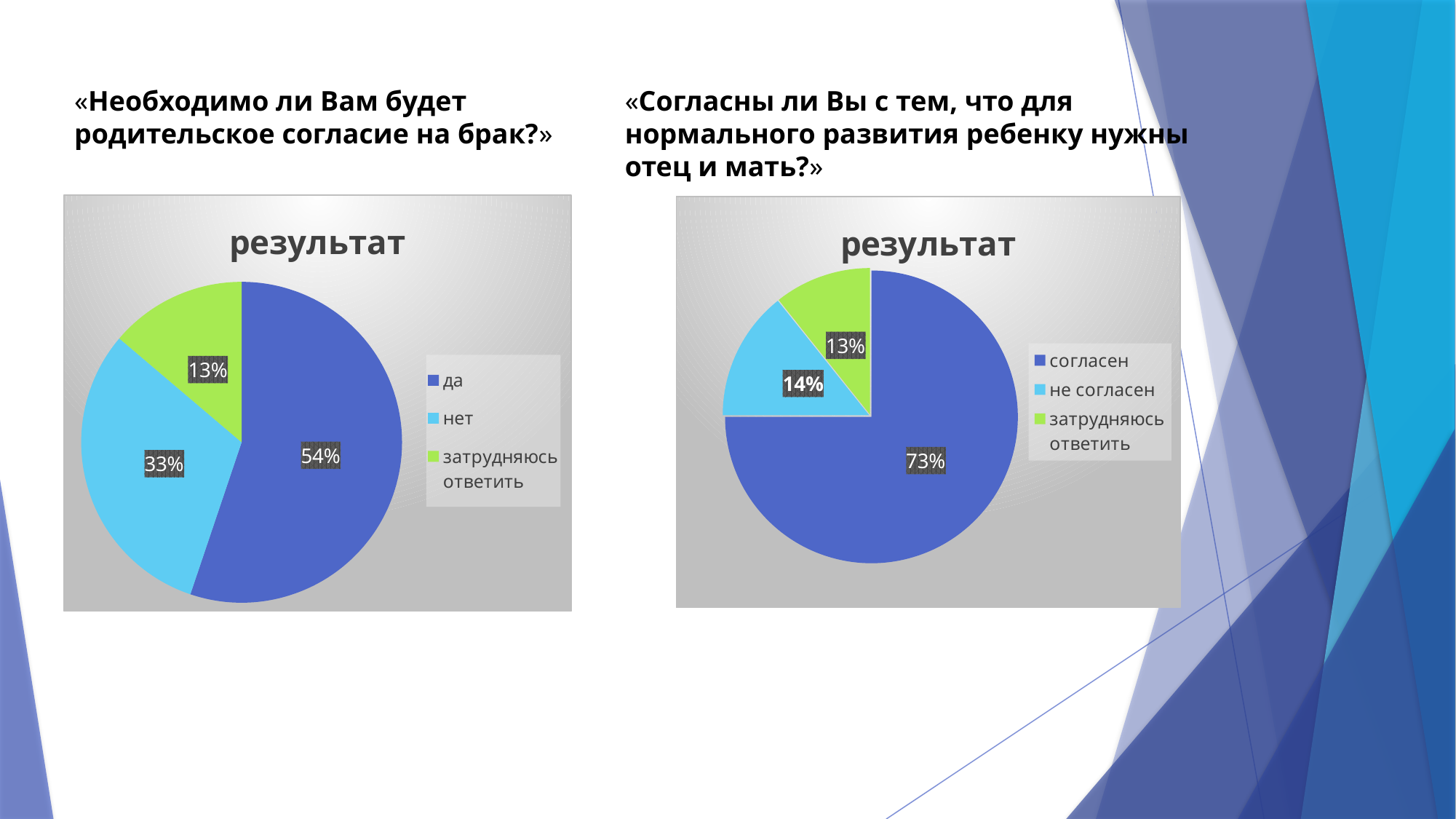
How many entries does the legend of the left chart (about parental consent for marriage) list? 3 In the right chart (about a child needing a father and mother), what is the difference in percentage points between "согласен" and "не согласен"? 59 In the right chart (about a child needing a father and mother), which answer has the smallest share? затрудняюсь ответить In the left chart (about parental consent for marriage), what share of respondents answered "да"? 54% In the left chart (about parental consent for marriage), what is the difference in percentage points between "да" and "нет"? 21 In the right chart (about a child needing a father and mother), what share of respondents answered "согласен"? 73% Which is larger in the left chart (about parental consent for marriage): the share for "нет" or the share for "затрудняюсь ответить"? нет What type of chart is the right chart (about a child needing a father and mother)? Pie chart In the left chart (about parental consent for marriage), what share of respondents answered "затрудняюсь ответить"? 13% In the right chart (about a child needing a father and mother), what share of respondents answered "не согласен"? 14% In the left chart (about parental consent for marriage), which answer has the largest share? да In the left chart (about parental consent for marriage), what share of respondents answered "нет"? 33%